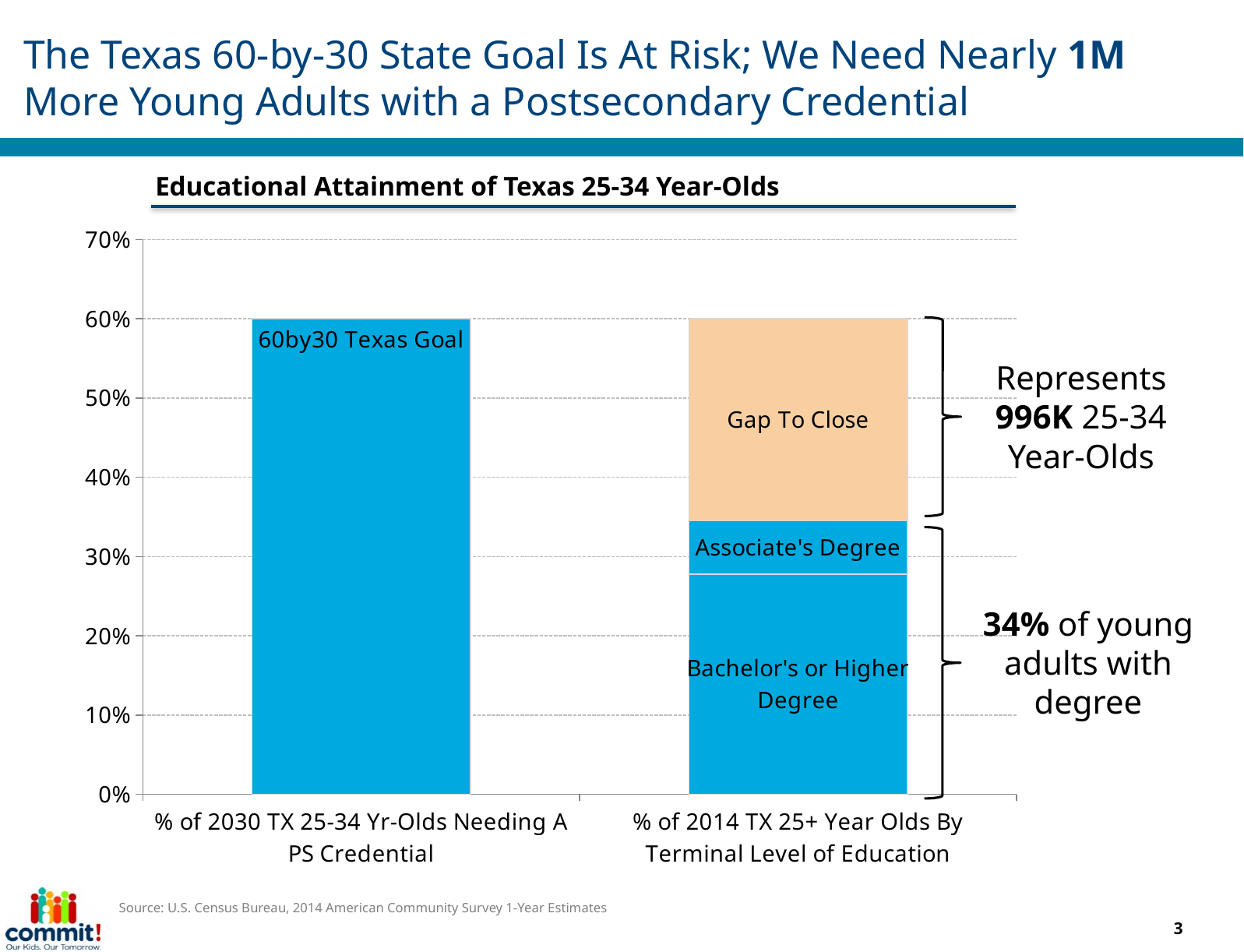
According to the annotation, what percentage of young adults have a degree? 34% Is the Bachelor's or Higher Degree segment greater or less than 20%? greater What is the total height of the stacked bar for % of 2014 TX 25+ Year Olds By Terminal Level of Education? 60% Is the Associate's Degree segment greater or less than 10%? less How many segments make up the stacked bar for % of 2014 TX 25+ Year Olds By Terminal Level of Education? 3 How many bars (categories) are plotted on the x axis? 2 What is the title of the chart? Educational Attainment of Texas 25-34 Year-Olds What value does the 60by30 Texas Goal bar reach? 60% According to the annotation, how many 25-34 year-olds does the Gap To Close represent? 996K What kind of chart is shown on the slide? bar chart Is the Gap To Close segment greater or less than 20%? greater Which segment is larger, Bachelor's or Higher Degree or Associate's Degree? Bachelor's or Higher Degree